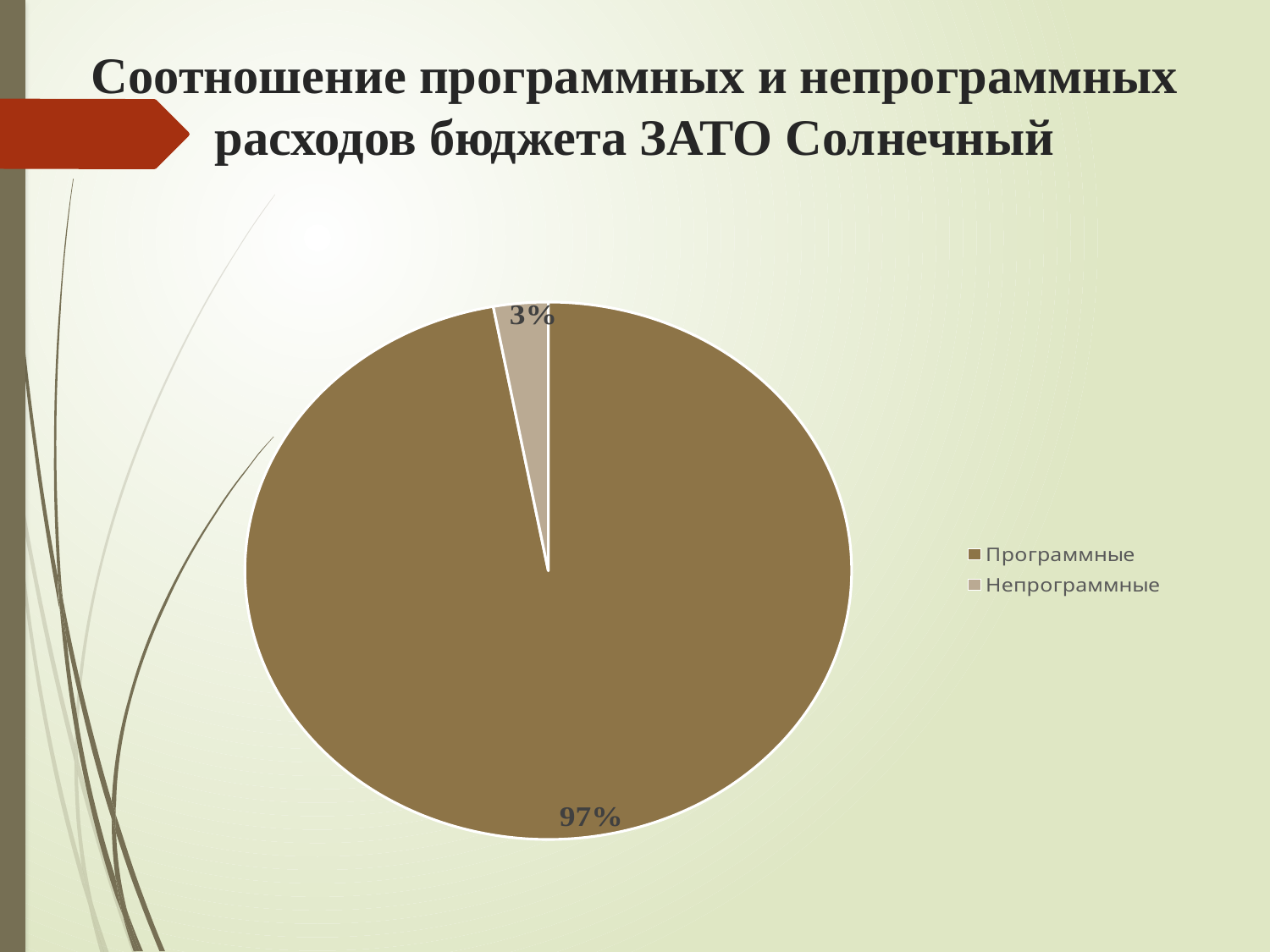
Which category has the largest slice of the pie? Программные What kind of chart is shown on the slide? pie chart What is the title of the slide containing the chart? Соотношение программных и непрограммных расходов бюджета ЗАТО Солнечный What share of the pie does Программные take? 97% How many entries does the legend list? 2 Which category has the smallest slice of the pie? Непрограммные Which is larger, the Программные slice or the Непрограммные slice? Программные How many slices does the pie chart have? 2 Which legend entry is shown in the darker brown colour? Программные What share of the pie does Непрограммные take? 3% What is the difference in percentage points between the Программные and Непрограммные slices? 94